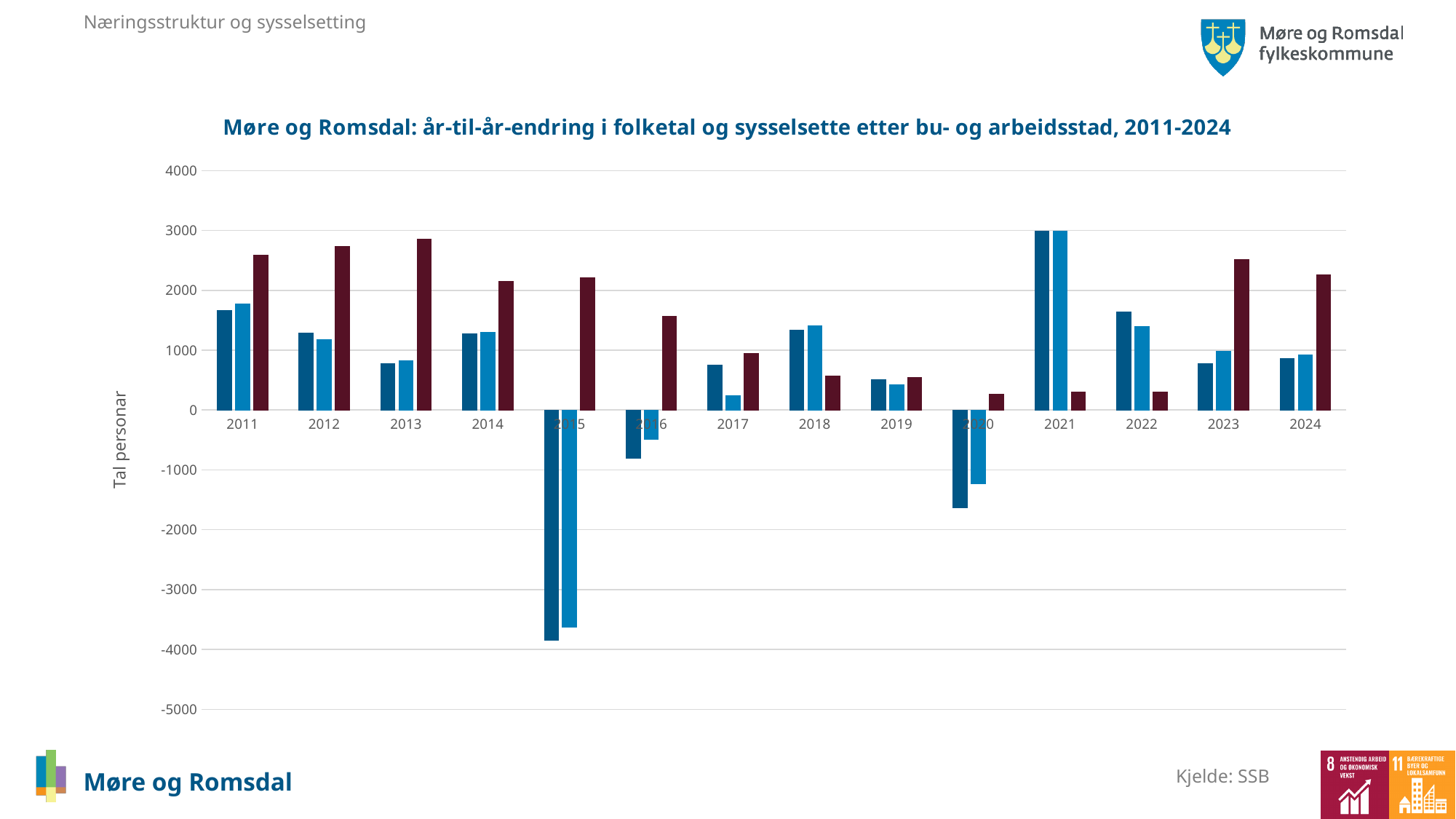
What kind of chart is shown on the slide? bar chart How many bars are plotted for each year in the chart? 3 Is the value of the dark blue bar for 2015 greater or less than -3000? less Is the value of the light blue bar for 2021 greater or less than 2000? greater Is the value of the dark red bar for 2011 greater or less than 2000? greater How many years are shown along the x axis of the chart? 14 What is the title of the chart? Møre og Romsdal: år-til-år-endring i folketal og sysselsette etter bu- og arbeidsstad, 2011-2024 Do the dark blue bars rise or fall from 2011 to 2013? fall In which year is the dark blue bar lowest? 2015 What is the label on the vertical axis of the chart? Tal personar Which is larger, the dark red bar for 2011 or the dark red bar for 2021? 2011